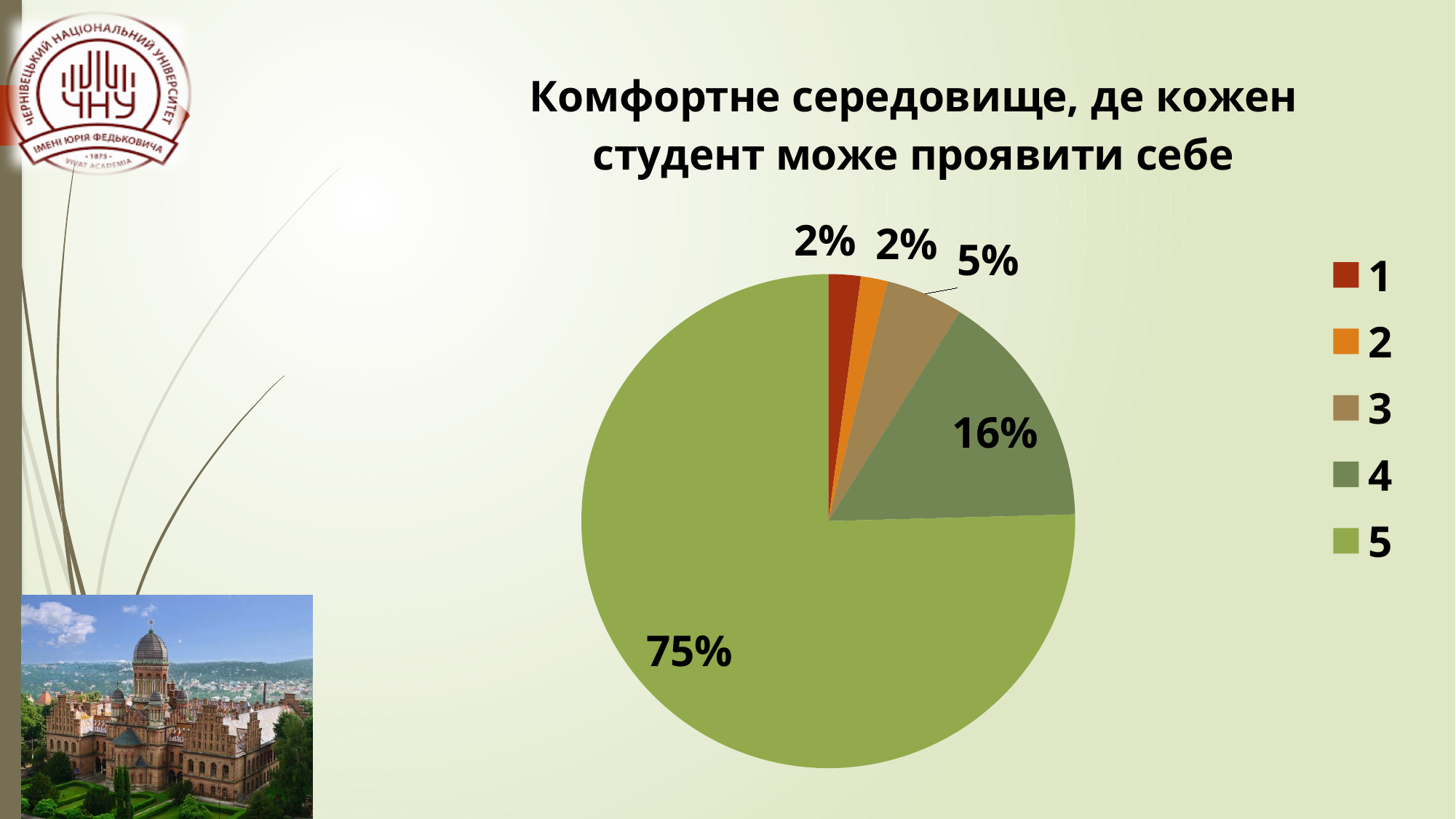
What share of the pie does category 3 have? 5% What is the difference between the shares of category 5 and category 4? 59% What share of the pie does category 4 have? 16% Which is larger, the share of category 4 or the share of category 3? 4 How many categories does the legend list? 5 Which category has the largest slice of the pie? 5 What type of chart is shown on the slide? pie chart What share of the pie does category 5 have? 75% What is the title of the chart? Комфортне середовище, де кожен студент може проявити себе What is the combined share of categories 1, 2 and 3? 9% What colour is the slice for category 5? green